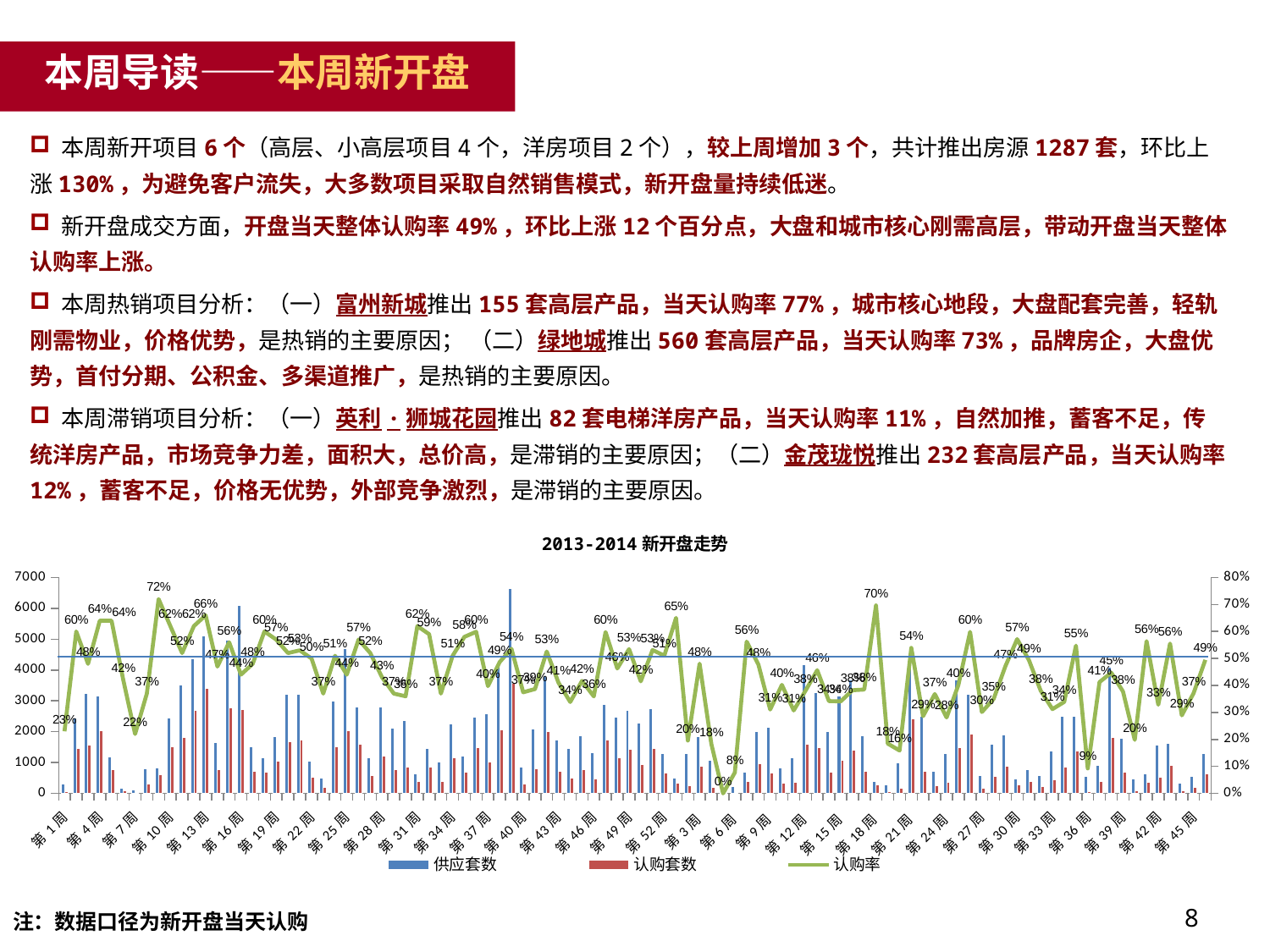
What is the lowest 认购率 value labelled on the line? 0% Is the tallest 供应套数 bar greater or less than 6000? greater What is the highest 认购率 value labelled on the line? 72% What is the 认购率 value labelled at the last point of the line? 49% Which is larger, the 72% peak or the 70% peak of the 认购率 line? 72% What is the difference between the 72% peak and the 70% peak of the 认购率 line? 2 percentage points What is the title of the chart? 2013-2014 新开盘走势 What is the 认购率 value labelled at the first point (第1周)? 23% What kind of chart is shown on the slide? A combined bar and line chart What are the three series named in the legend? 供应套数, 认购套数, 认购率 What is the maximum value shown on the right-hand percentage axis? 80% How many series does the chart legend list? 3